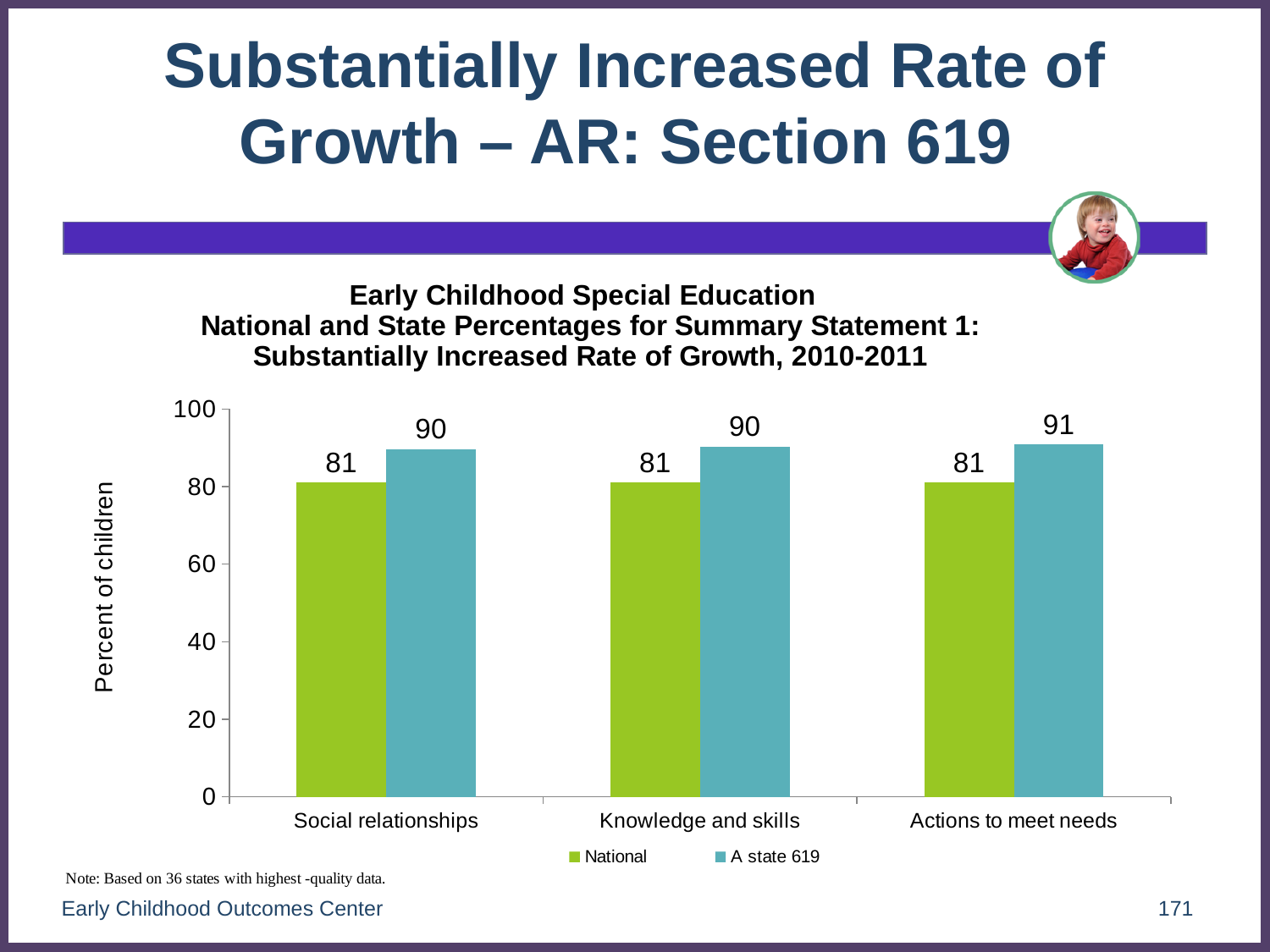
How many series does the legend list? 2 What is the label of the y axis? Percent of children What kind of chart is shown? Bar chart Is the National value for Knowledge and skills greater or less than 60? greater What is the difference between the A state 619 and National values for Actions to meet needs? 10 How many categories are shown on the x axis? 3 Which is larger for Knowledge and skills, the National value or the A state 619 value? A state 619 What is the difference between the A state 619 and National values for Social relationships? 9 What is the A state 619 value for Actions to meet needs? 91 Which category has the highest A state 619 value? Actions to meet needs What is the A state 619 value for Knowledge and skills? 90 What is the National value for Social relationships? 81